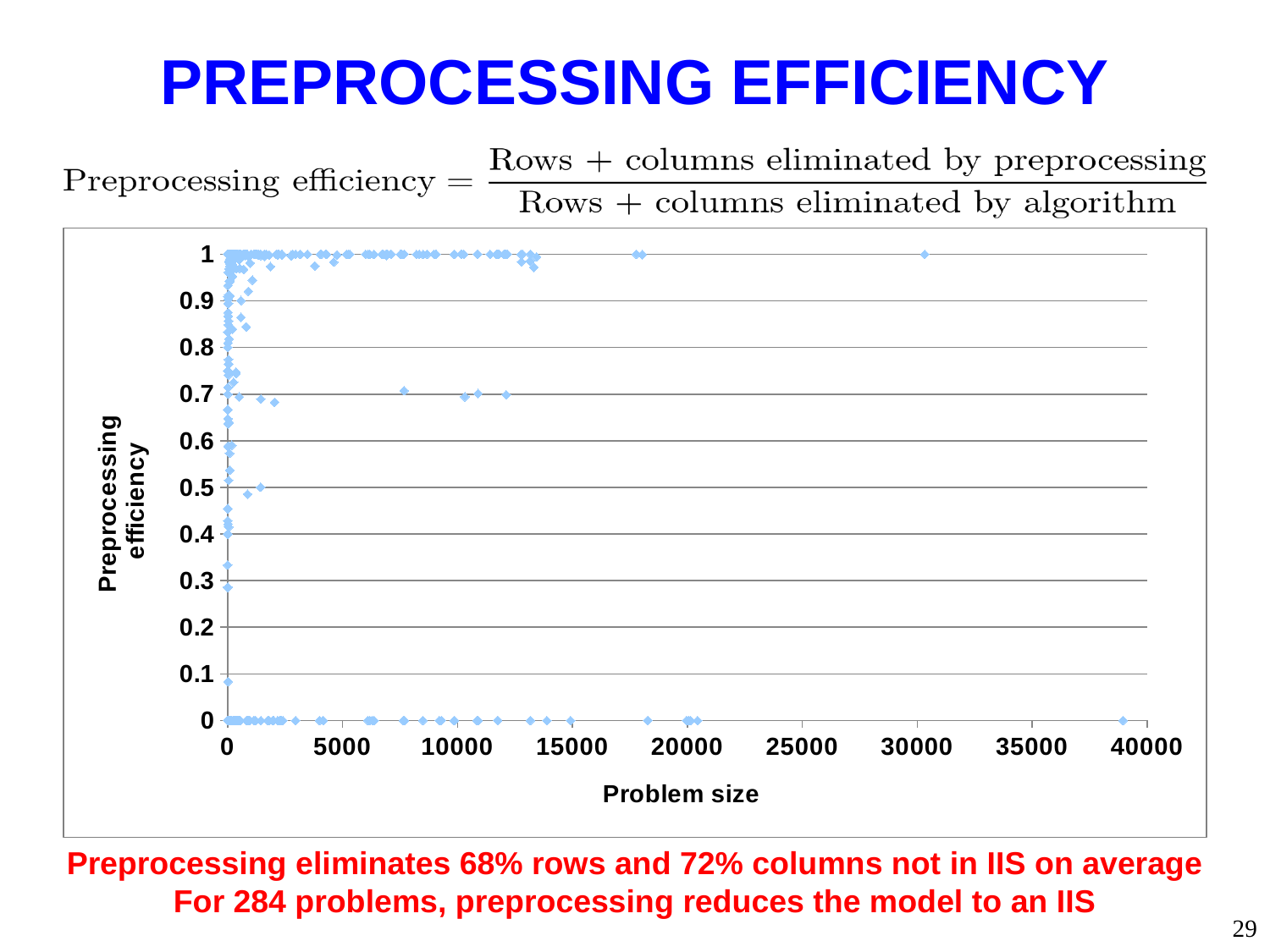
What is the title of the y axis of the chart? Preprocessing efficiency Is the preprocessing efficiency of the rightmost point (problem size near 39000) greater or less than 0.1? less What is the highest preprocessing efficiency value reached by any point on the chart? 1 Is the preprocessing efficiency of the point at a problem size of about 30000 greater or less than 0.9? greater What is the title of the x axis of the chart? Problem size What is the lowest preprocessing efficiency value reached by any point on the chart? 0 Which has the higher preprocessing efficiency: the point at a problem size of about 30000 or the point at a problem size of about 39000? the point at about 30000 What kind of chart is shown on the slide? scatter chart